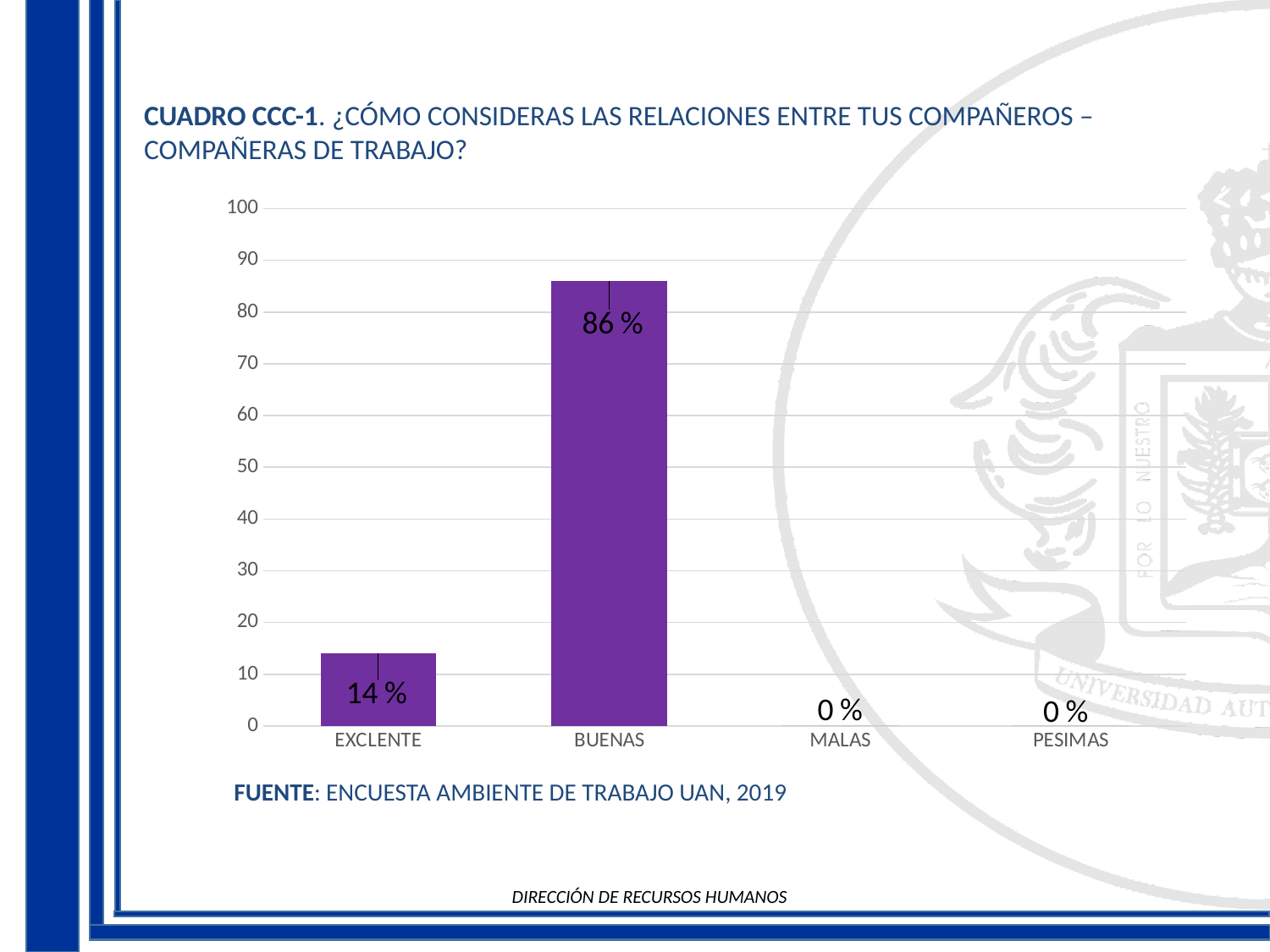
What is the value for BUENAS? 86 % Is the value for BUENAS greater or less than 80? greater What is the combined value of MALAS and PESIMAS? 0 % Is the value for EXCLENTE greater or less than 20? less What source is cited below the chart? ENCUESTA AMBIENTE DE TRABAJO UAN, 2019 How many categories are shown on the x axis? 4 What is the value for EXCLENTE? 14 % What kind of chart is shown on the slide? Bar chart Which is larger, the value for EXCLENTE or the value for BUENAS? BUENAS What is the value for MALAS? 0 % What is the difference between the values for BUENAS and EXCLENTE? 72 % Which category has the highest value? BUENAS